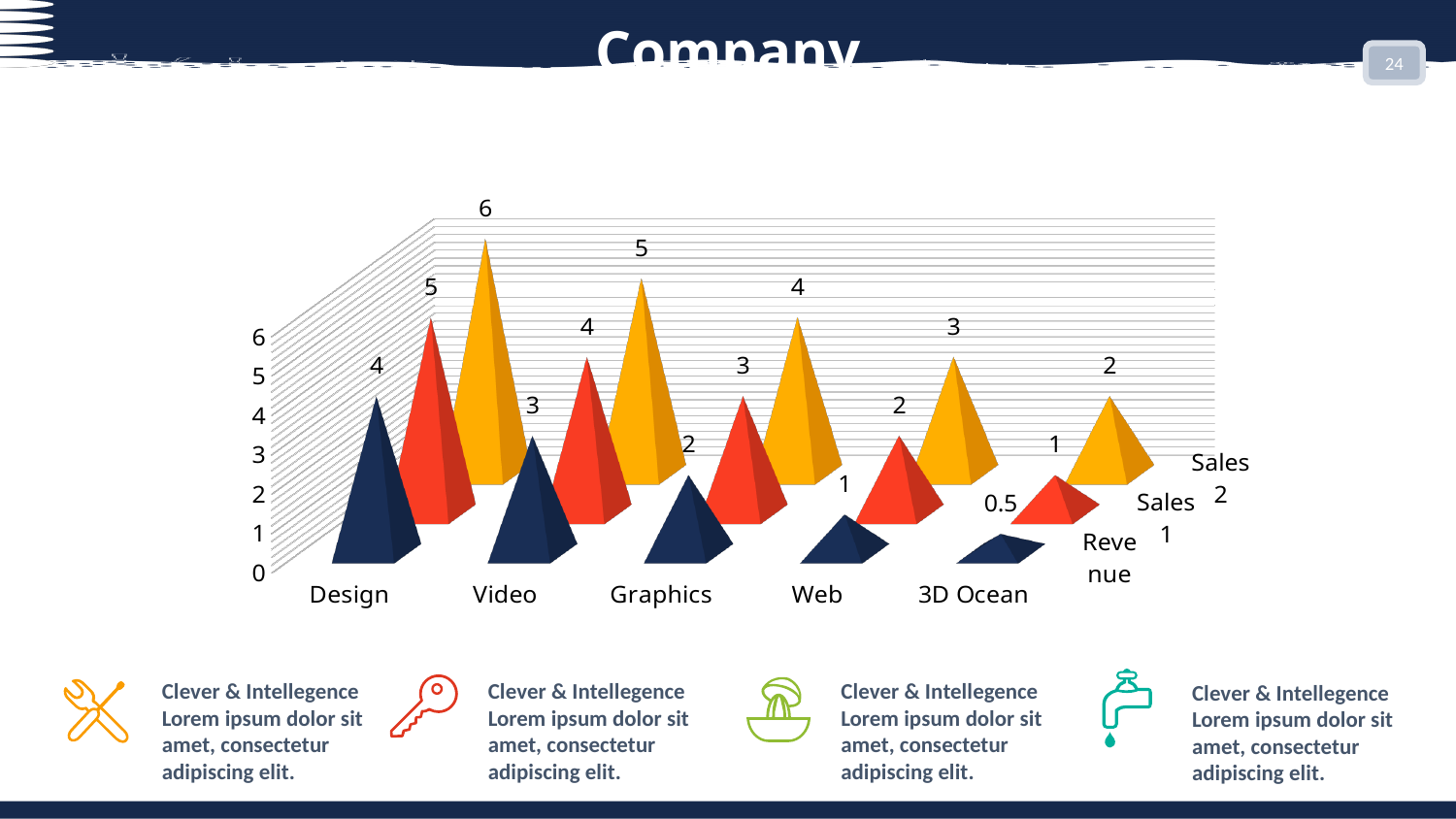
Which category has the highest Sales 2 value? Design Do the Sales 2 values rise or fall from Design to 3D Ocean? fall What kind of chart is shown on the slide? bar chart What is the Revenue value for Design? 4 What is the difference between the Sales 2 value and the Revenue value for Web? 2 How many categories are shown on the x axis? 5 Which is larger, the Sales 1 value for Video or the Sales 1 value for Web? Video What is the Sales 2 value for Video? 5 Which category has the lowest Revenue value? 3D Ocean What is the Revenue value for 3D Ocean? 0.5 How many data series are plotted in the chart? 3 What is the Sales 1 value for Graphics? 3